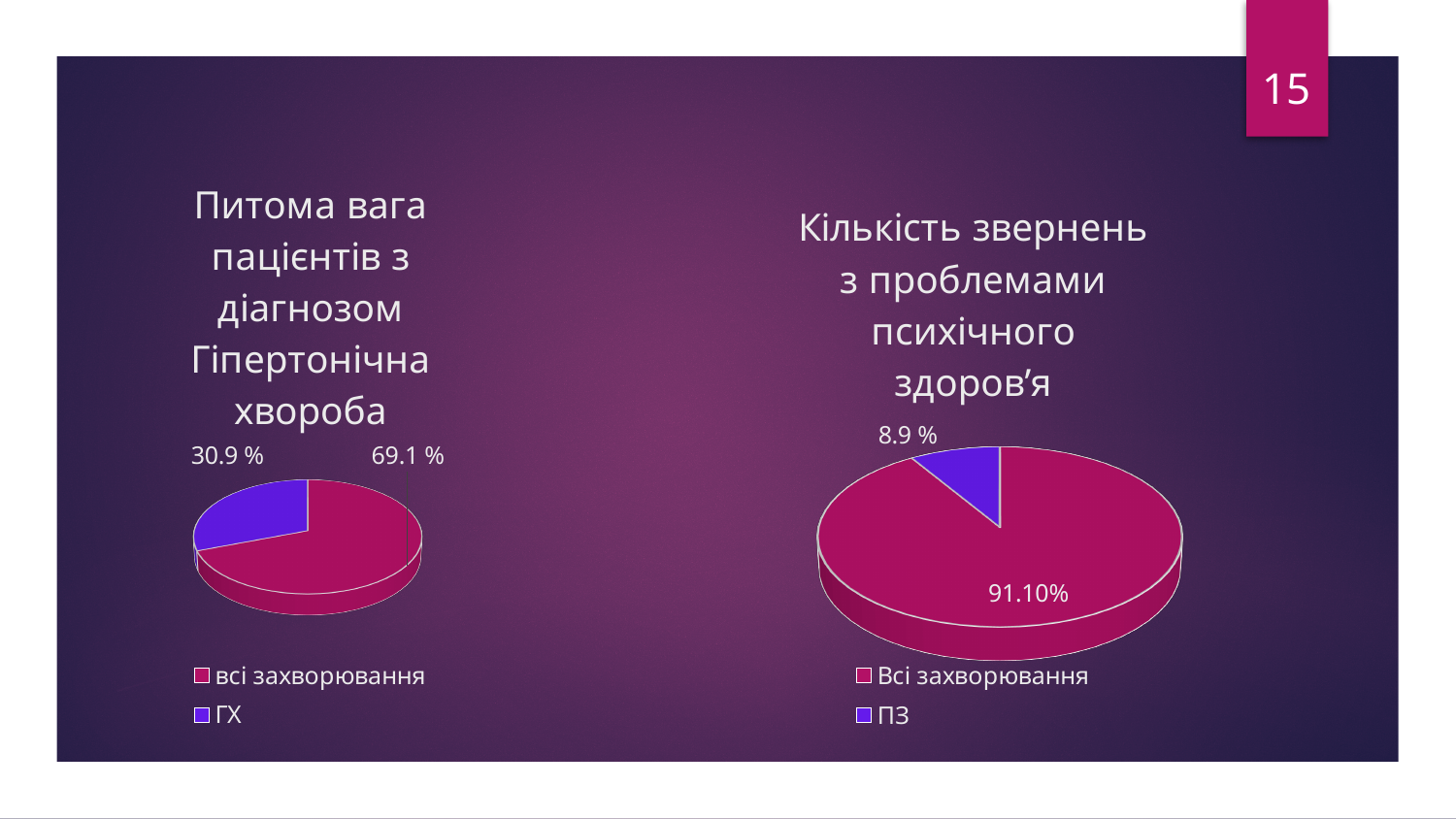
What colour is the ПЗ slice in the right chart (Кількість звернень з проблемами психічного здоров’я)? blue How many slices does the right chart (Кількість звернень з проблемами психічного здоров’я) have? 2 In the right chart (Кількість звернень з проблемами психічного здоров’я), what share is shown for Всі захворювання? 91.10% What is the title of the chart on the right side of the slide? Кількість звернень з проблемами психічного здоров’я In the left chart (Питома вага пацієнтів з діагнозом Гіпертонічна хвороба), what share is shown for ГХ? 30.9 % In the right chart (Кількість звернень з проблемами психічного здоров’я), which slice is the smallest? ПЗ In the right chart (Кількість звернень з проблемами психічного здоров’я), which slice is the largest? Всі захворювання How many entries does the legend of the left chart (Питома вага пацієнтів з діагнозом Гіпертонічна хвороба) list? 2 In the left chart (Питома вага пацієнтів з діагнозом Гіпертонічна хвороба), what share is shown for всі захворювання? 69.1 % In the left chart (Питома вага пацієнтів з діагнозом Гіпертонічна хвороба), which slice is larger: всі захворювання or ГХ? всі захворювання What type of chart is the left chart titled "Питома вага пацієнтів з діагнозом Гіпертонічна хвороба"? pie chart